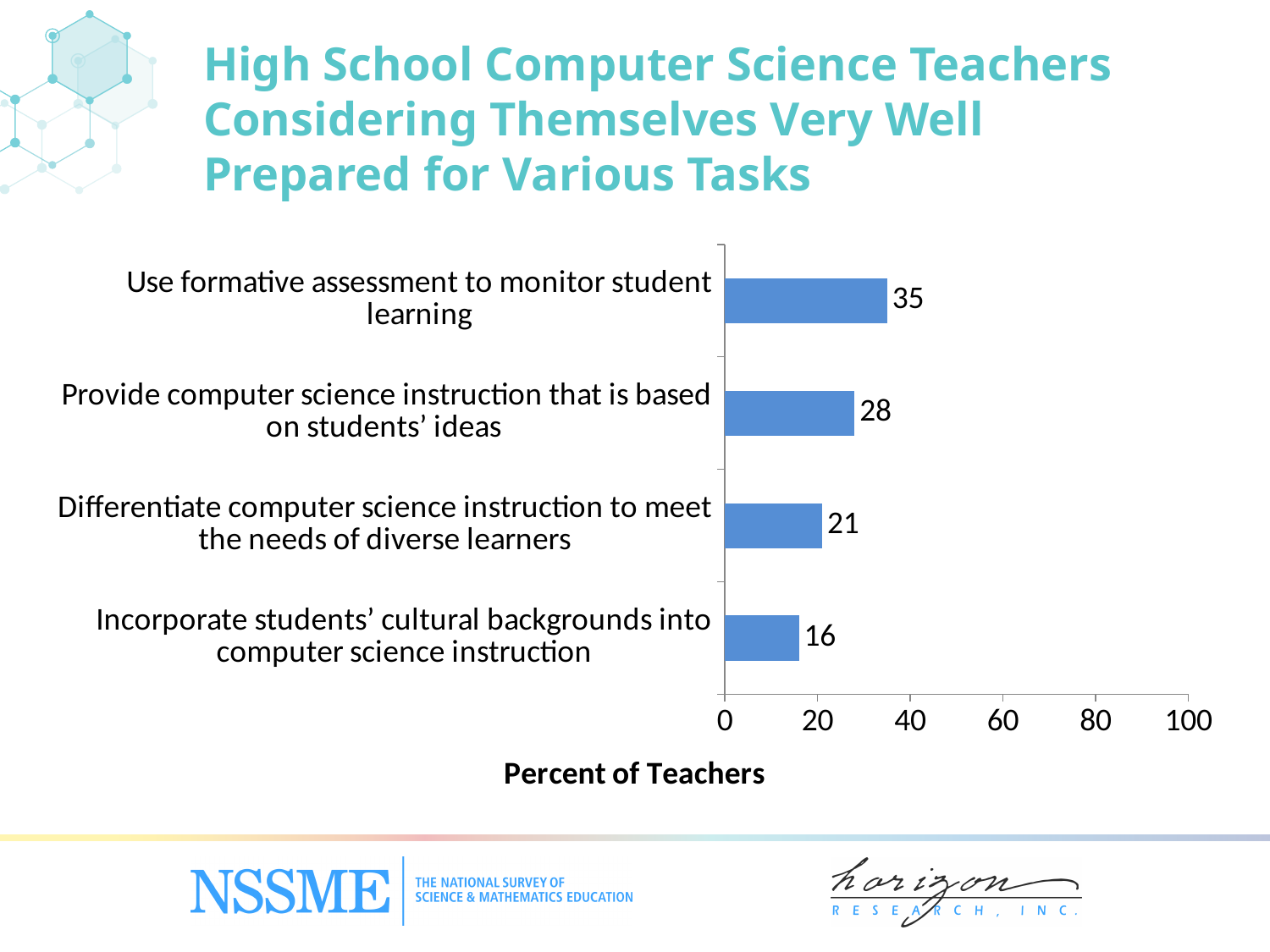
Which task has the lowest percent of teachers considering themselves very well prepared? Incorporate students' cultural backgrounds into computer science instruction How many tasks are shown in the chart? 4 What percent of teachers consider themselves very well prepared to provide computer science instruction that is based on students' ideas? 28 What percent of teachers consider themselves very well prepared to differentiate computer science instruction to meet the needs of diverse learners? 21 Which has a higher percent of teachers: providing instruction based on students' ideas or differentiating instruction for diverse learners? Provide computer science instruction that is based on students' ideas What is the difference in percent of teachers between using formative assessment to monitor student learning and incorporating students' cultural backgrounds into computer science instruction? 19 What kind of chart is shown on the slide? Bar chart Which task has the highest percent of teachers considering themselves very well prepared? Use formative assessment to monitor student learning Is the value for using formative assessment to monitor student learning greater or less than 40? less What percent of teachers consider themselves very well prepared to use formative assessment to monitor student learning? 35 What is the label of the horizontal axis? Percent of Teachers What percent of teachers consider themselves very well prepared to incorporate students' cultural backgrounds into computer science instruction? 16